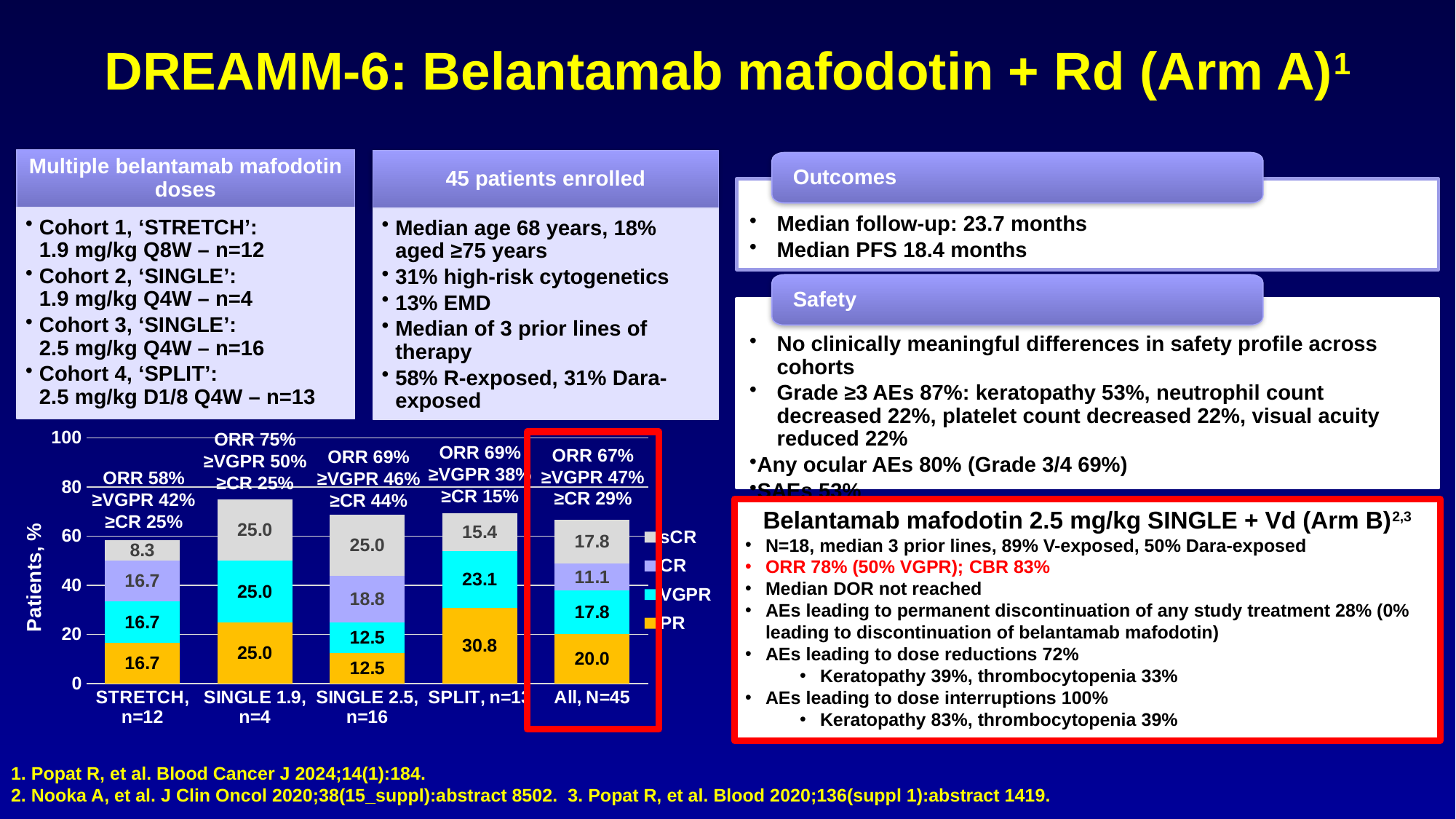
What is the sCR value for the STRETCH, n=12 cohort? 8.3 What is the CR value for the All, N=45 bar? 11.1 Which cohort has the highest PR value? SPLIT, n=13 How many series does the chart legend list? 4 How many cohort categories are plotted along the x axis of the chart? 5 What type of chart is shown on the slide? Stacked bar chart Which cohort has the lowest PR value? SINGLE 2.5, n=16 Which legend entry is shown in orange? PR Which is larger: the VGPR value for SINGLE 1.9, n=4 or the VGPR value for SINGLE 2.5, n=16? SINGLE 1.9, n=4 What is the difference between the PR value for SPLIT, n=13 and the PR value for All, N=45? 10.8 What is the total of the stacked bar for the STRETCH, n=12 cohort? 58.4 What is the PR value for the SPLIT, n=13 cohort? 30.8